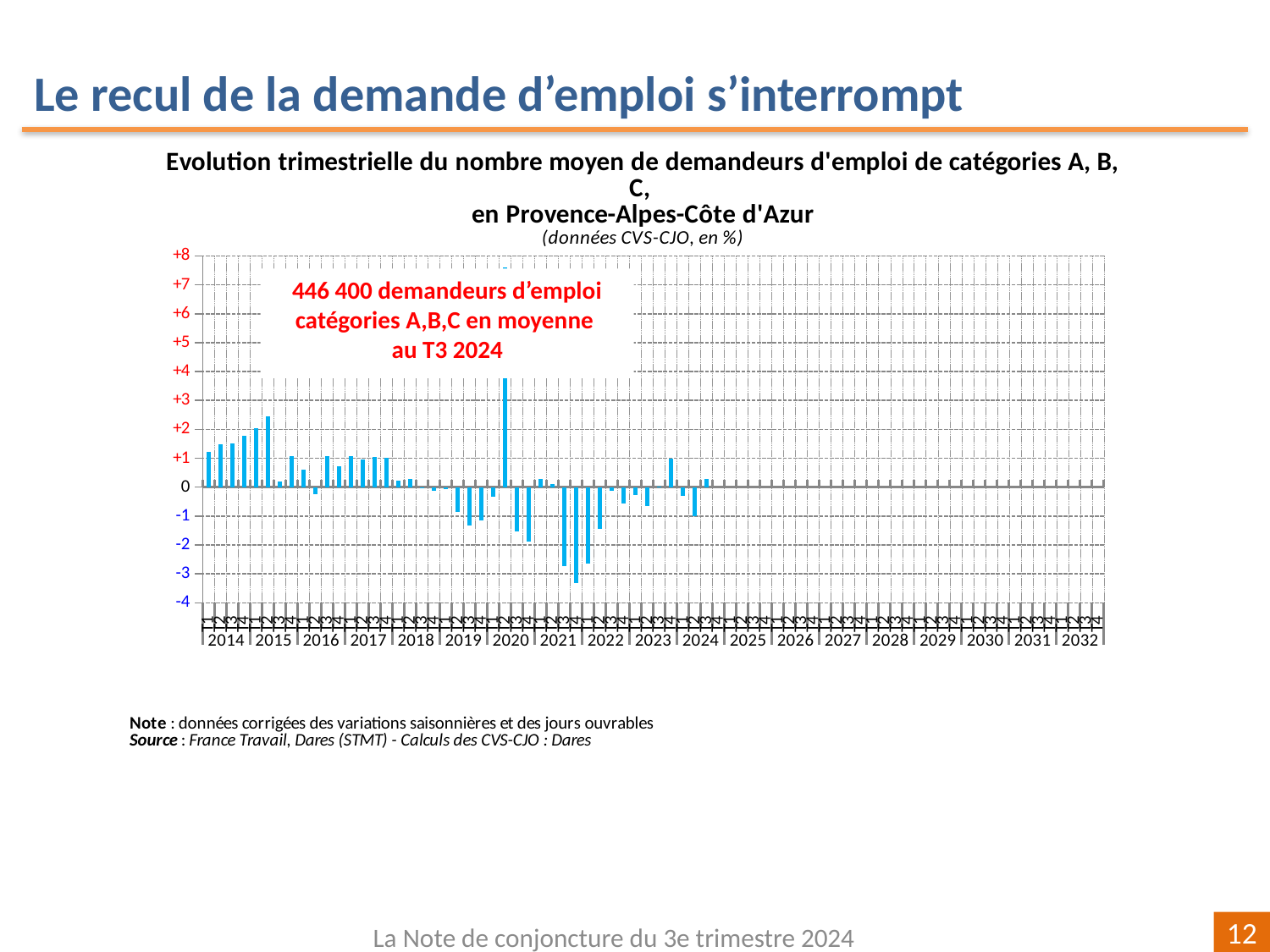
What kind of chart is shown on the slide? bar chart Which region does the chart title refer to? Provence-Alpes-Côte d'Azur Is the value of the lowest bar in 2021 greater or less than -2? less How many year labels are shown on the x axis? 19 Do the bars for 2014 lie above or below 0? above According to the annotation on the chart, how many job seekers in categories A, B, C were there on average in T3 2024? 446 400 Is the value of the tallest bar in 2015 greater or less than +2? greater In which year does the lowest bar of the chart appear? 2021 In which year does the highest bar of the chart appear? 2020